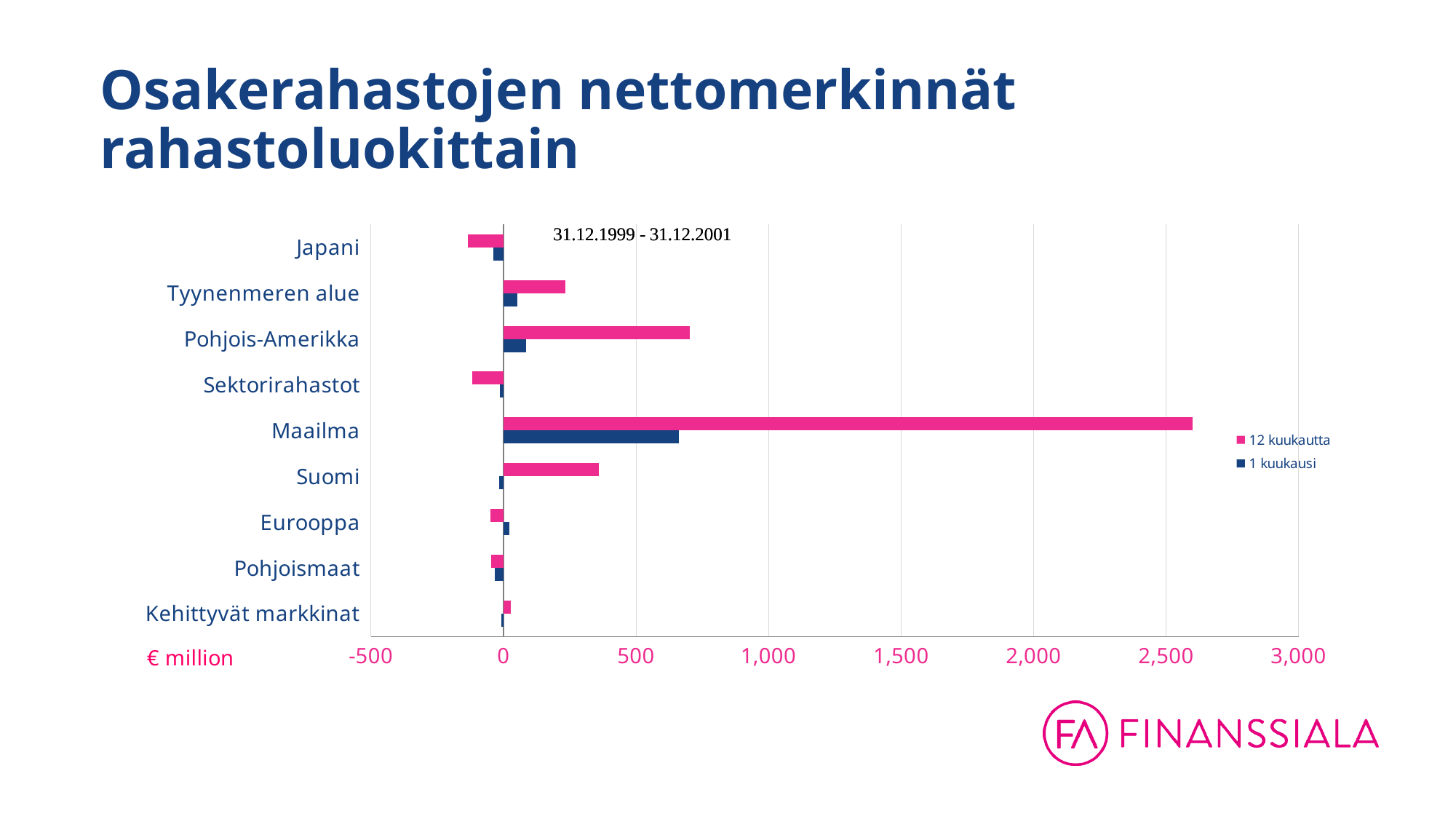
What unit is shown for the horizontal axis of the chart? € million Is the 1 kuukausi value for Maailma greater or less than 500? greater Is the 12 kuukautta value for Maailma greater or less than 2,500? greater How many fund categories are listed on the chart? 9 Is the 12 kuukautta value for Pohjois-Amerikka greater or less than 500? greater For Maailma, which series has the larger value: 12 kuukautta or 1 kuukausi? 12 kuukautta What kind of chart is shown on the slide? bar chart Which category has the highest value for the 1 kuukausi series? Maailma Which category has the highest value for the 12 kuukautta series? Maailma For the 12 kuukautta series, which is larger: Pohjois-Amerikka or Suomi? Pohjois-Amerikka How many series does the legend list? 2